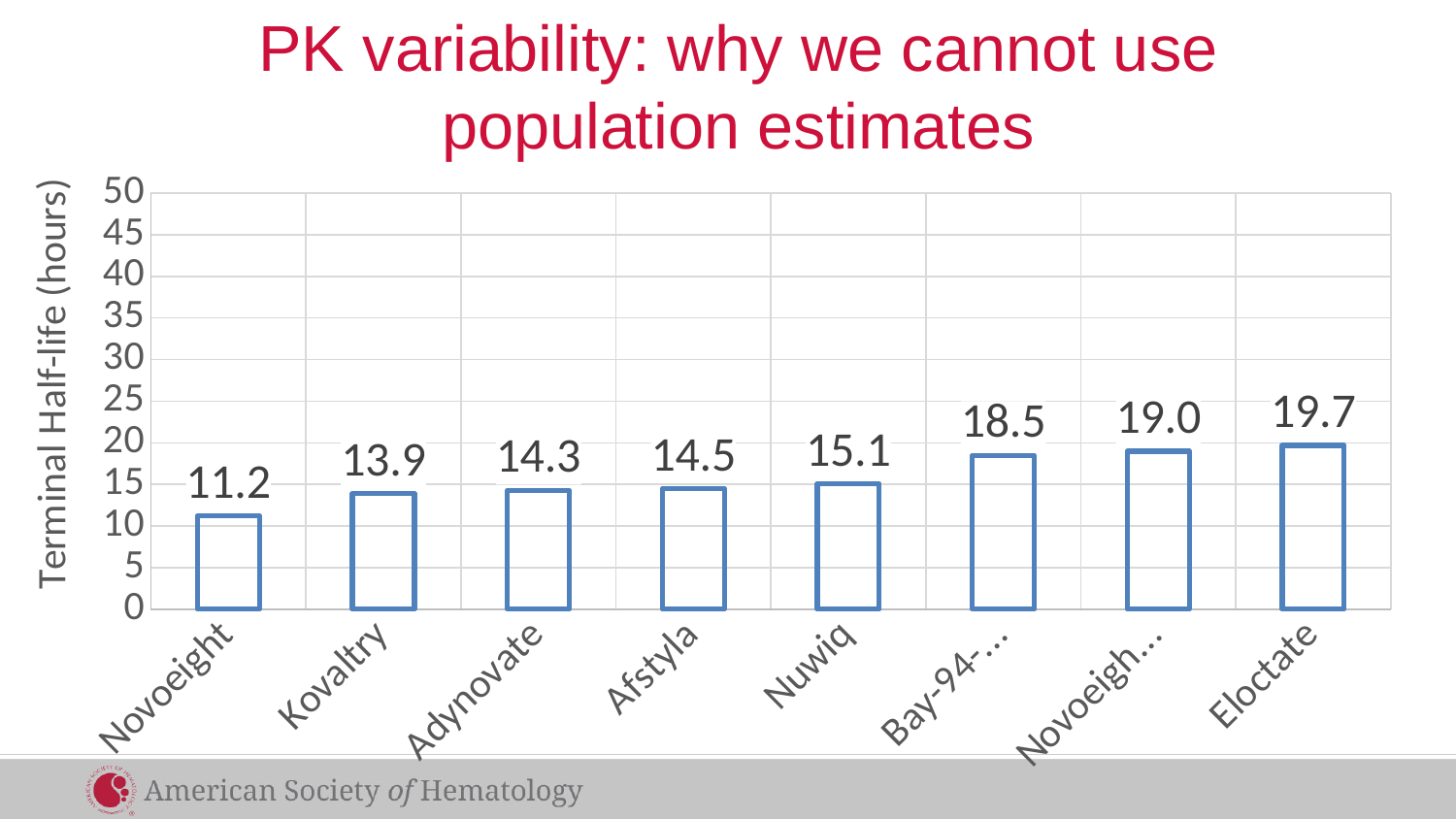
Which has a longer terminal half-life, Nuwiq or Adynovate? Nuwiq What is the terminal half-life shown for Afstyla? 14.5 What is the terminal half-life shown for Adynovate? 14.3 What is the label of the vertical axis? Terminal Half-life (hours) Which product has the highest terminal half-life on the chart? Eloctate What is the terminal half-life shown for Novoeight (the first bar)? 11.2 What is the difference in terminal half-life between Eloctate and Kovaltry? 5.8 How many bars are plotted on the chart? 8 What is the terminal half-life shown for Eloctate? 19.7 What is the terminal half-life shown for Nuwiq? 15.1 What is the terminal half-life shown for Kovaltry? 13.9 Which product has the lowest terminal half-life on the chart? Novoeight (the first bar)